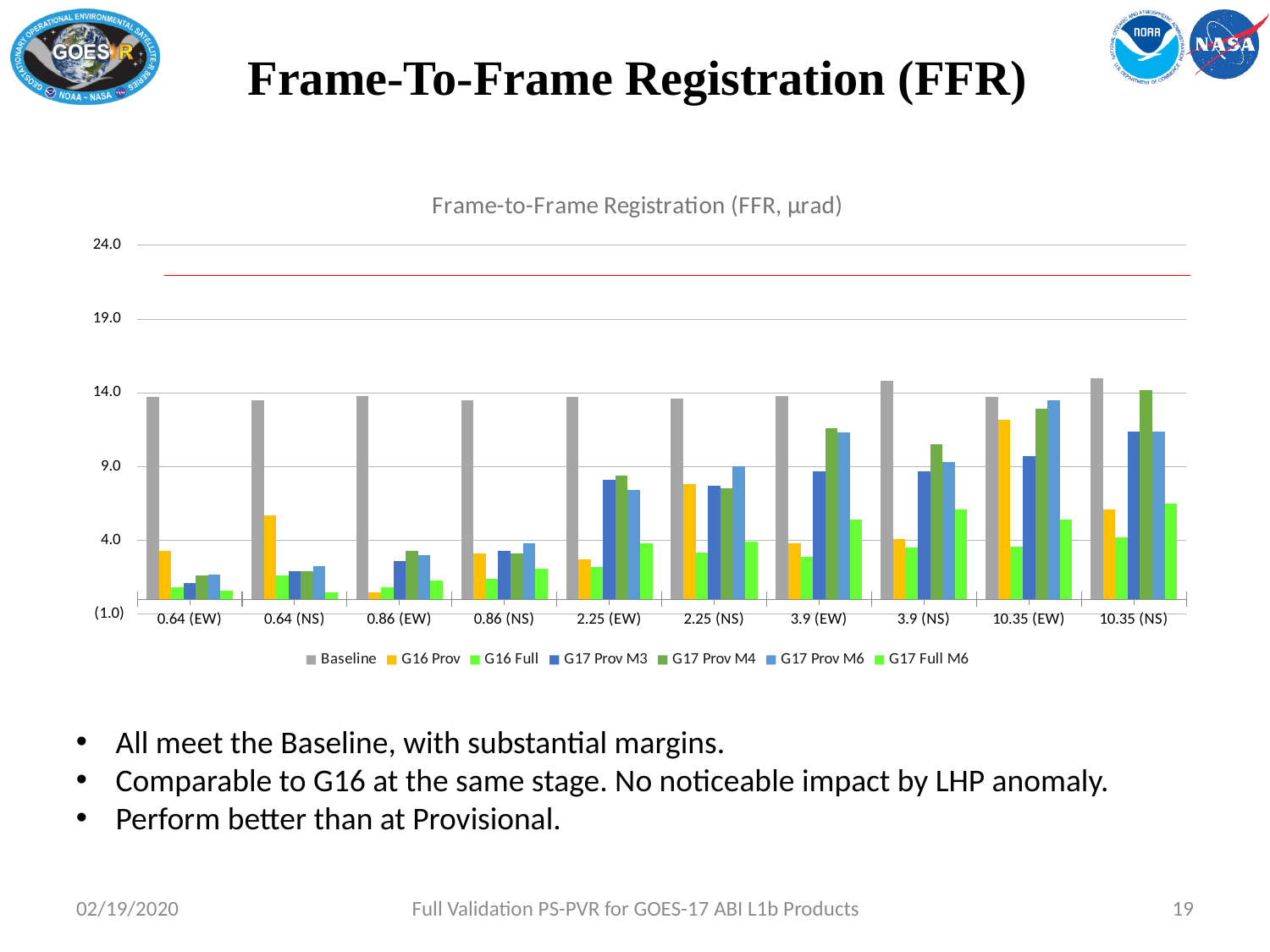
Is the G17 Full M6 value for 2.25 (EW) greater or less than 9.0? less Which series has the highest value for the 0.64 (EW) category? Baseline How many series does the chart's legend list? 7 Which series is shown in gray in the chart's legend? Baseline What kind of chart is shown on the slide? bar chart Is the Baseline value for 0.64 (EW) greater or less than 9.0? greater What is the title of the chart? Frame-to-Frame Registration (FFR, μrad) Do the G17 Prov M3 values generally rise or fall from 0.64 (EW) to 10.35 (NS) along the x axis? rise For the 0.64 (NS) category, which is larger: G16 Prov or G16 Full? G16 Prov How many categories are shown along the x axis of the chart? 10 Is the G16 Prov value for 10.35 (EW) greater or less than 9.0? greater